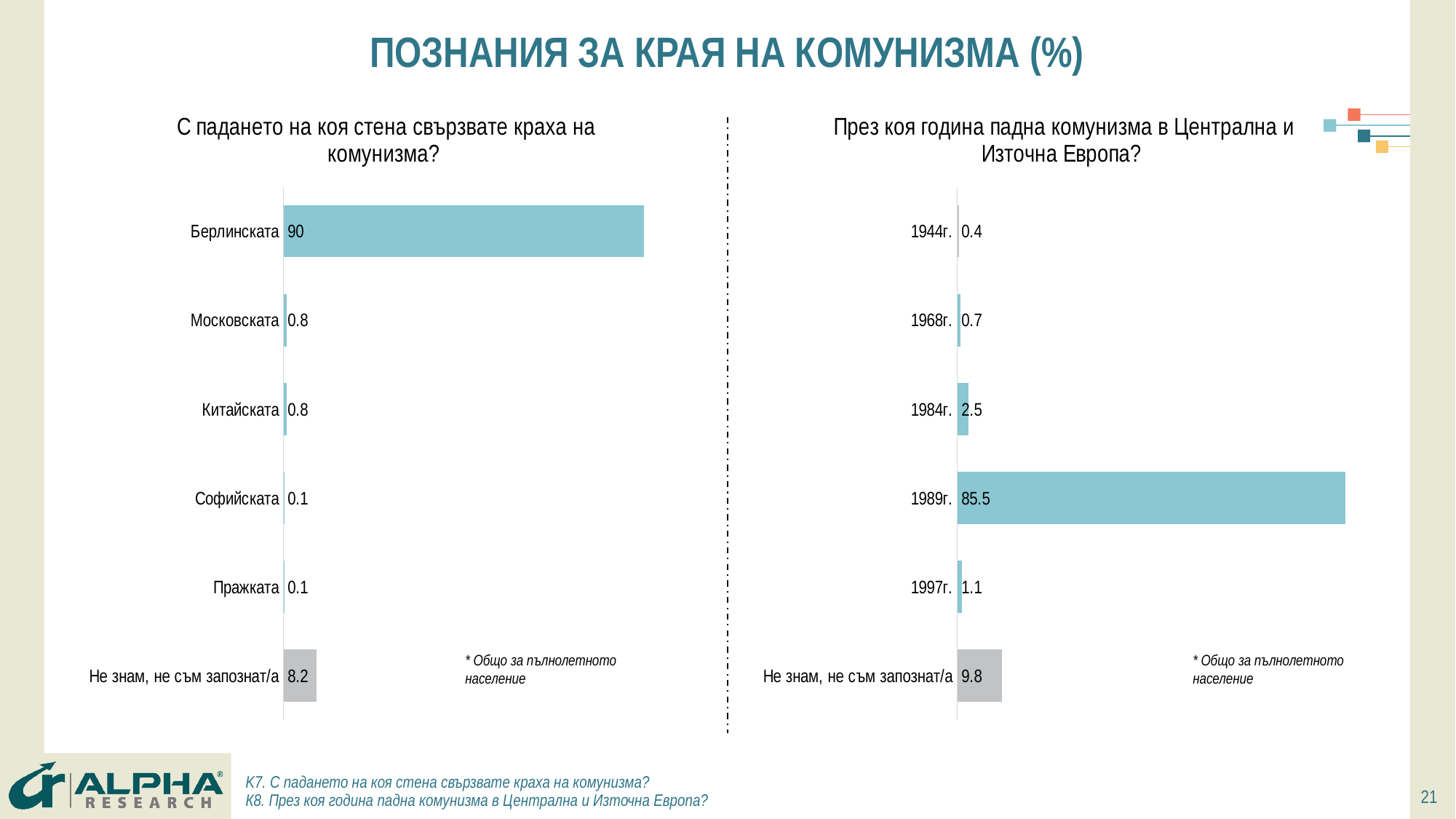
What is the title of the slide? ПОЗНАНИЯ ЗА КРАЯ НА КОМУНИЗМА (%) In the left chart, which category has the highest value? Берлинската In the right chart ("През коя година падна комунизма в Централна и Източна Европа?"), what is the value for 1989г.? 85.5 In the left chart, what is the value for Не знам, не съм запознат/а? 8.2 In the right chart, what is the difference between the values for Не знам, не съм запознат/а and 1984г.? 7.3 In the left chart, what is the difference between the values for Берлинската and Не знам, не съм запознат/а? 81.8 In the left chart, how many categories are shown? 6 In the left chart ("С падането на коя стена свързвате краха на комунизма?"), what is the value for Берлинската? 90 In the right chart, what is the value for 1984г.? 2.5 In the right chart, which is larger: the value for 1997г. or the value for 1968г.? 1997г. In the right chart, which category has the lowest value? 1944г. What type of chart is used on the right side of the slide? Bar chart